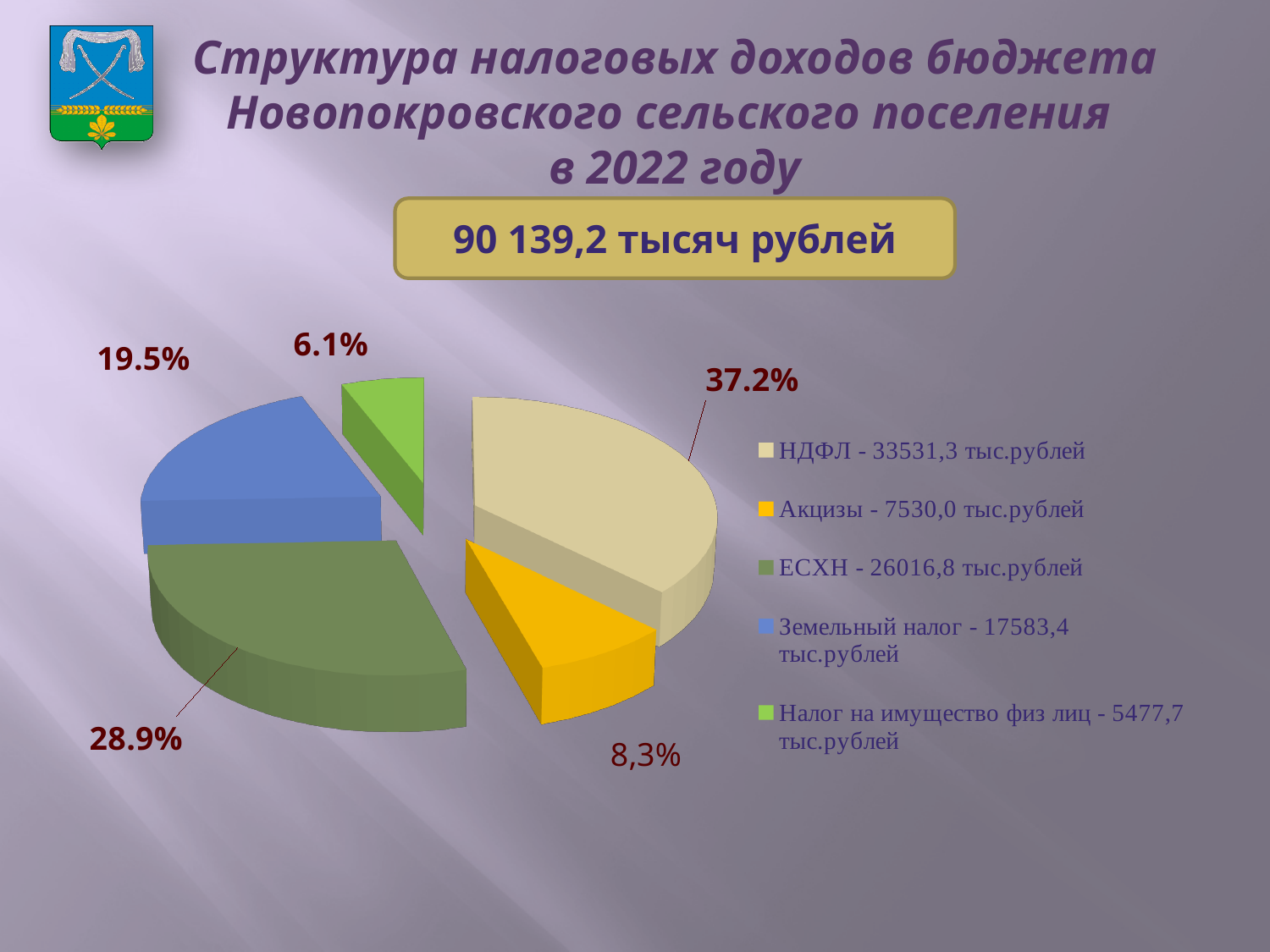
What share of the pie does ЕСХН represent? 28.9% Which is larger, the share for Земельный налог or the share for Акцизы? Земельный налог What share of the pie does Налог на имущество физ лиц represent? 6.1% What share of the pie does НДФЛ represent? 37.2% What kind of chart is shown on the slide? pie chart According to the legend, what is the value for ЕСХН? 26016,8 тыс.рублей Which category has the smallest slice of the pie? Налог на имущество физ лиц How many entries does the legend of the pie chart list? 5 Which category has the largest slice of the pie? НДФЛ How many slices does the pie chart have? 5